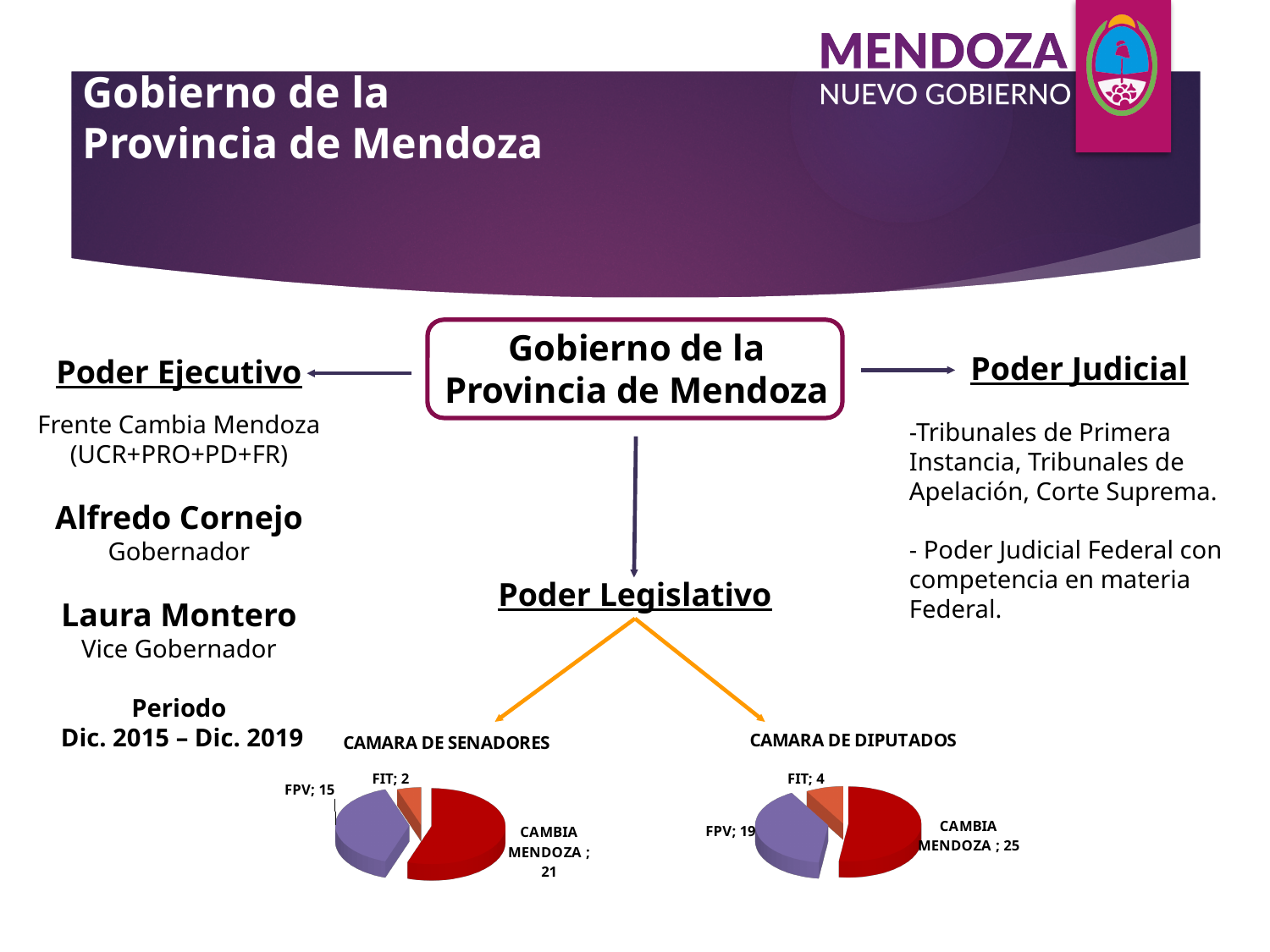
What kind of chart is the CAMARA DE SENADORES chart? Pie chart In the CAMARA DE SENADORES chart, which category has the smallest slice? FIT What is the total of all values in the CAMARA DE SENADORES chart? 38 Is the value for FPV larger in the CAMARA DE SENADORES chart or in the CAMARA DE DIPUTADOS chart? CAMARA DE DIPUTADOS In the CAMARA DE DIPUTADOS chart, what is the value for FIT? 4 How many categories are shown in the CAMARA DE DIPUTADOS chart? 3 In the CAMARA DE SENADORES chart, what is the value for CAMBIA MENDOZA? 21 In the CAMARA DE SENADORES chart, what is the difference between the values for CAMBIA MENDOZA and FPV? 6 In the CAMARA DE DIPUTADOS chart, what is the value for FPV? 19 In the CAMARA DE SENADORES chart, what is the value for FPV? 15 In the CAMARA DE DIPUTADOS chart, which category has the largest slice? CAMBIA MENDOZA In the CAMARA DE DIPUTADOS chart, what is the difference between the values for FPV and FIT? 15